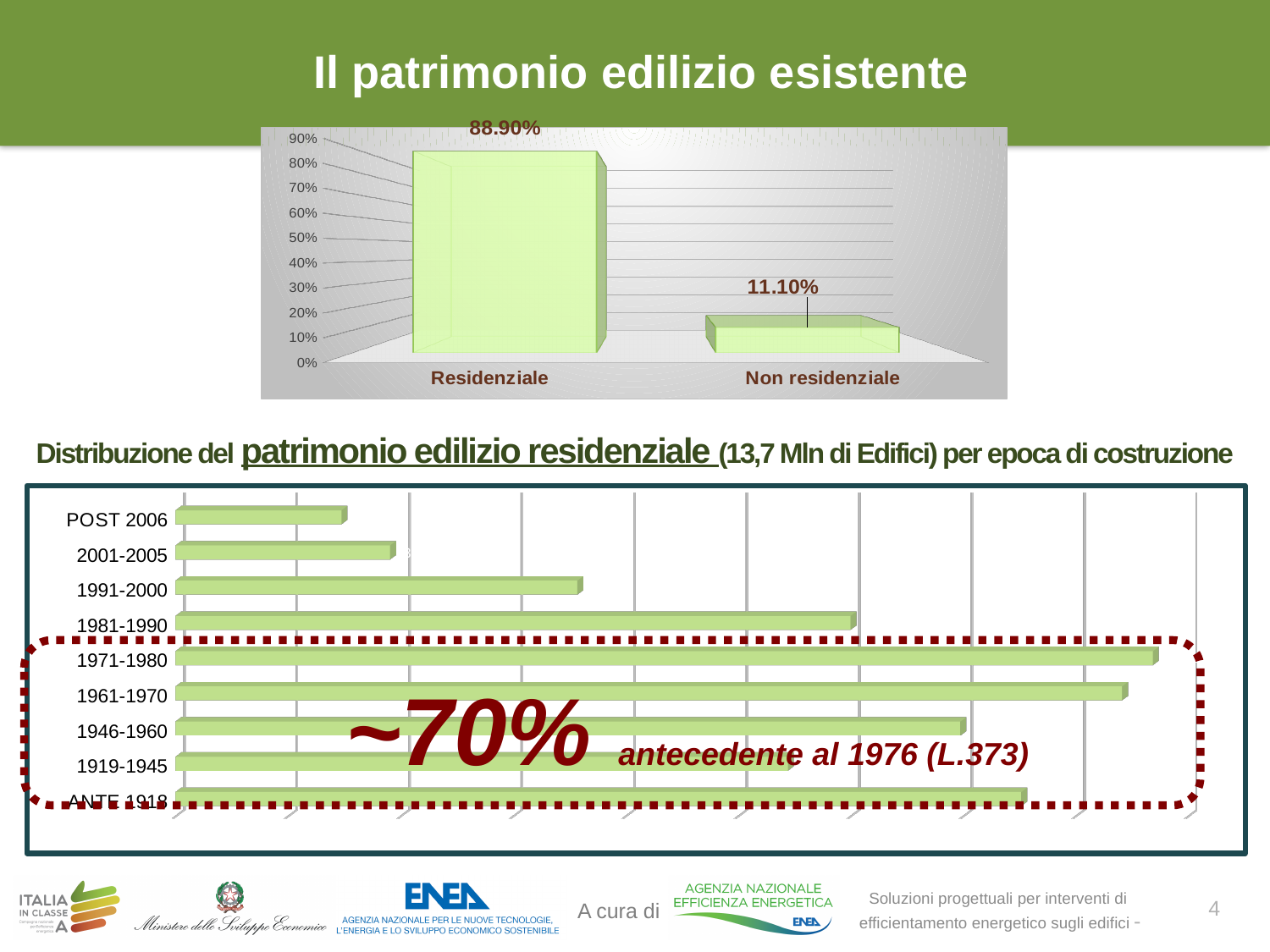
What kind of chart is the top chart? Bar chart In the bottom chart (distribution by construction era), which era has the longest bar? 1971-1980 In the bottom chart (distribution by construction era), how many construction eras are listed? 9 In the top chart, what is the value for Residenziale? 88.90% In the top chart, what is the value for Non residenziale? 11.10% In the bottom chart (distribution by construction era), which bar is longer: 1991-2000 or 2001-2005? 1991-2000 In the top chart, is the value for Non residenziale greater or less than 20%? less In the top chart, how many categories are shown? 2 What kind of chart is the bottom chart (distribution by construction era)? Bar chart In the bottom chart (distribution by construction era), which era has the shortest bar? POST 2006 In the top chart, what is the difference between the Residenziale and Non residenziale values? 77.80% In the top chart, which category has the higher value? Residenziale